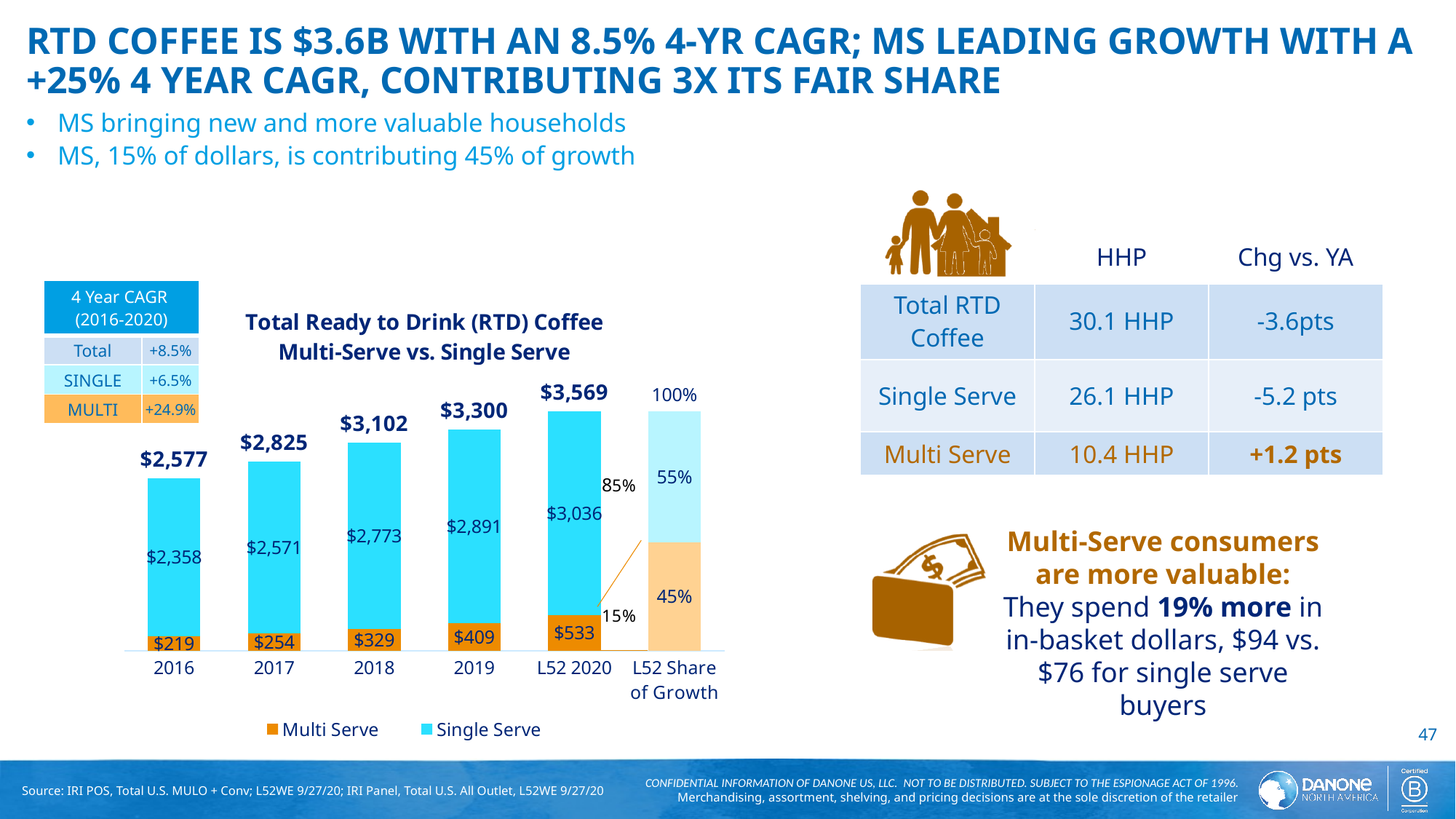
In the Total Ready to Drink (RTD) Coffee chart, is the Single Serve value larger in 2017 or in 2016? 2017 In the Total Ready to Drink (RTD) Coffee chart, which year has the lowest Multi Serve value? 2016 In the Total Ready to Drink (RTD) Coffee chart, which period has the highest Single Serve value? L52 2020 Which colour represents Multi Serve in the Total Ready to Drink (RTD) Coffee chart? Orange What kind of chart is the Total Ready to Drink (RTD) Coffee chart? Stacked bar chart What is the Multi Serve value for 2018 in the Total Ready to Drink (RTD) Coffee chart? $329 How many series does the legend of the Total Ready to Drink (RTD) Coffee chart list? 2 What is the total shown above the L52 2020 bar in the Total Ready to Drink (RTD) Coffee chart? $3,569 In the Total Ready to Drink (RTD) Coffee chart, what share of the L52 Share of Growth bar is Multi Serve? 45% In the Total Ready to Drink (RTD) Coffee chart, do the bar totals rise or fall from 2016 to L52 2020? Rise In the Total Ready to Drink (RTD) Coffee chart, what is the difference between the Multi Serve values for L52 2020 and 2019? $124 What is the Single Serve value for 2019 in the Total Ready to Drink (RTD) Coffee chart? $2,891